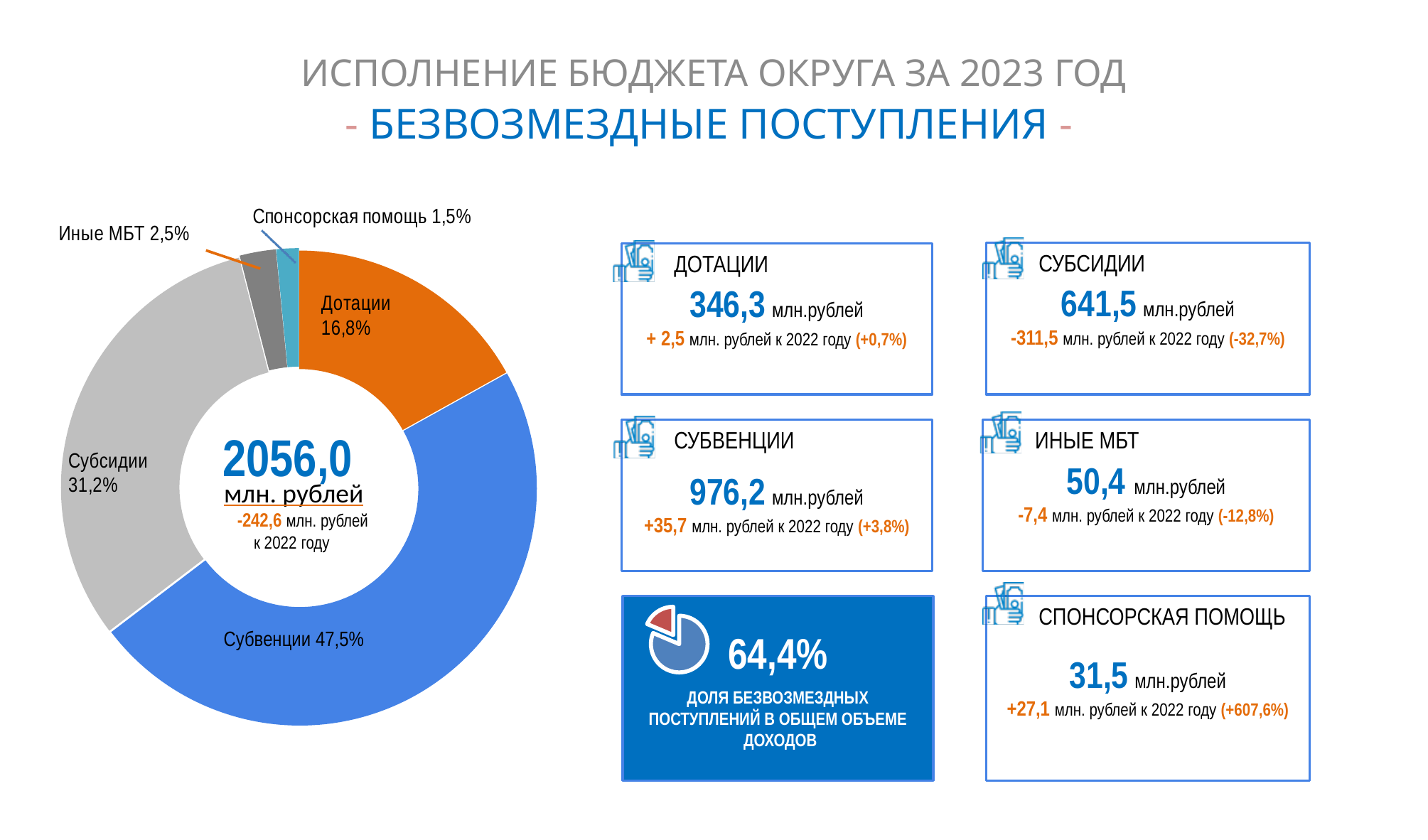
What share of the donut chart is Субвенции? 47,5% What share of the donut chart is Спонсорская помощь? 1,5% Which category has the smallest slice in the donut chart? Спонсорская помощь How many slices does the donut chart have? 5 What share of the donut chart is Субсидии? 31,2% What is the difference in percentage points between the Субвенции and Субсидии slices in the donut chart? 16,3 In the donut chart, which slice is larger: Субсидии or Дотации? Субсидии Which category has the largest slice in the donut chart? Субвенции What total value is printed in the centre of the donut chart? 2056,0 млн. рублей What kind of chart is shown on the left of the slide? Donut (pie) chart